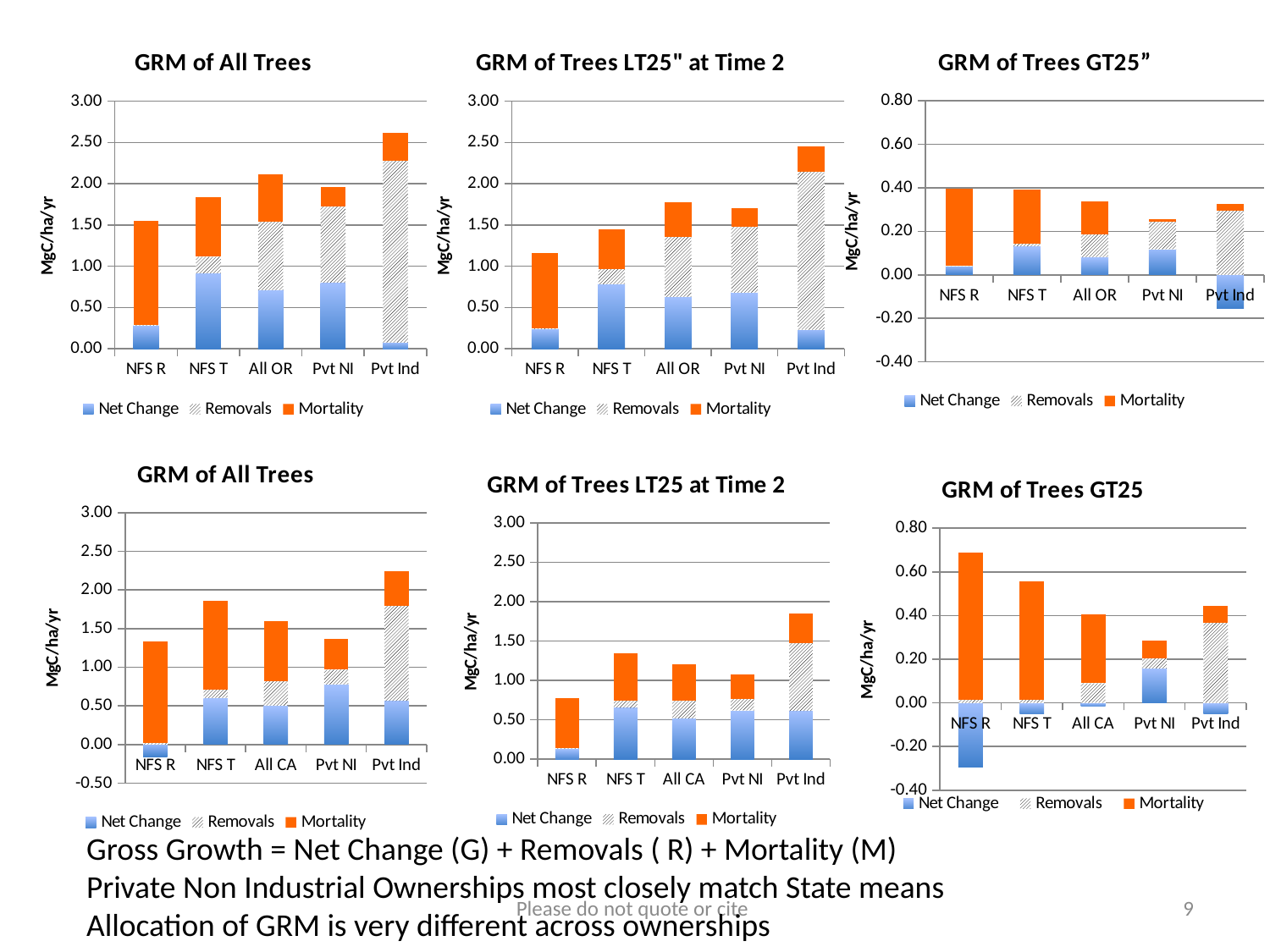
In the bottom-right chart (GRM of Trees GT25), is the top of the NFS R bar greater or less than 0.60? greater In the top-left chart (GRM of All Trees), is the top of the Pvt Ind stacked bar greater or less than 2.50? greater In the bottom-middle chart (GRM of Trees LT25 at Time 2), is the top of the NFS R stacked bar greater or less than 1.00? less In the top-middle chart (GRM of Trees LT25" at Time 2), which category has the shortest stacked bar? NFS R In the bottom-right chart (GRM of Trees GT25), which category has the tallest bar above zero? NFS R In the top-right chart (GRM of Trees GT25"), which category has a negative Net Change value? Pvt Ind In the bottom-left chart (GRM of All Trees), which category has the tallest stacked bar? Pvt Ind How many series does the legend of the top-middle chart (GRM of Trees LT25" at Time 2) list? 3 What kind of chart is the top-left chart titled "GRM of All Trees"? Stacked bar chart In the top-left chart (GRM of All Trees), which category has the tallest stacked bar? Pvt Ind In the top-left chart (GRM of All Trees), how many ownership categories are shown on the x axis? 5